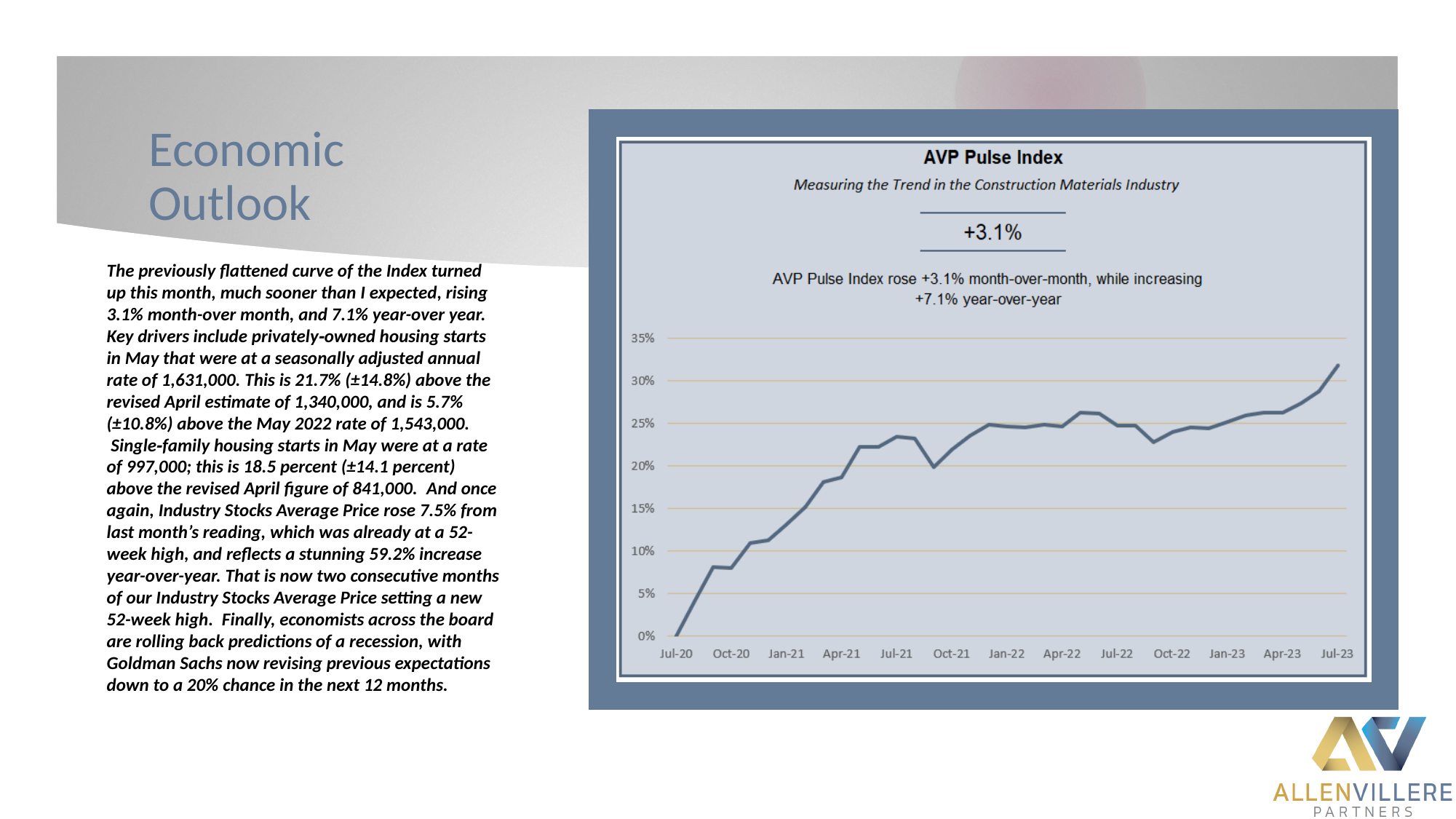
What kind of chart is shown on the slide? line chart What month-over-month change does the chart report for the AVP Pulse Index? +3.1% At which x-axis label is the AVP Pulse Index lowest? Jul-20 What is the value of the AVP Pulse Index at Jul-20? 0% Is the value for Jul-23 greater or less than 30%? greater What is the title of the chart? AVP Pulse Index Which is larger, the value at Apr-21 or the value at Apr-22? Apr-22 Overall, does the AVP Pulse Index rise or fall from Jul-20 to Jul-23? rise At which x-axis label is the AVP Pulse Index highest? Jul-23 What year-over-year change does the chart report for the AVP Pulse Index? +7.1% Is the value for Apr-21 greater or less than 20%? less What does the chart's subtitle say it measures? Measuring the Trend in the Construction Materials Industry